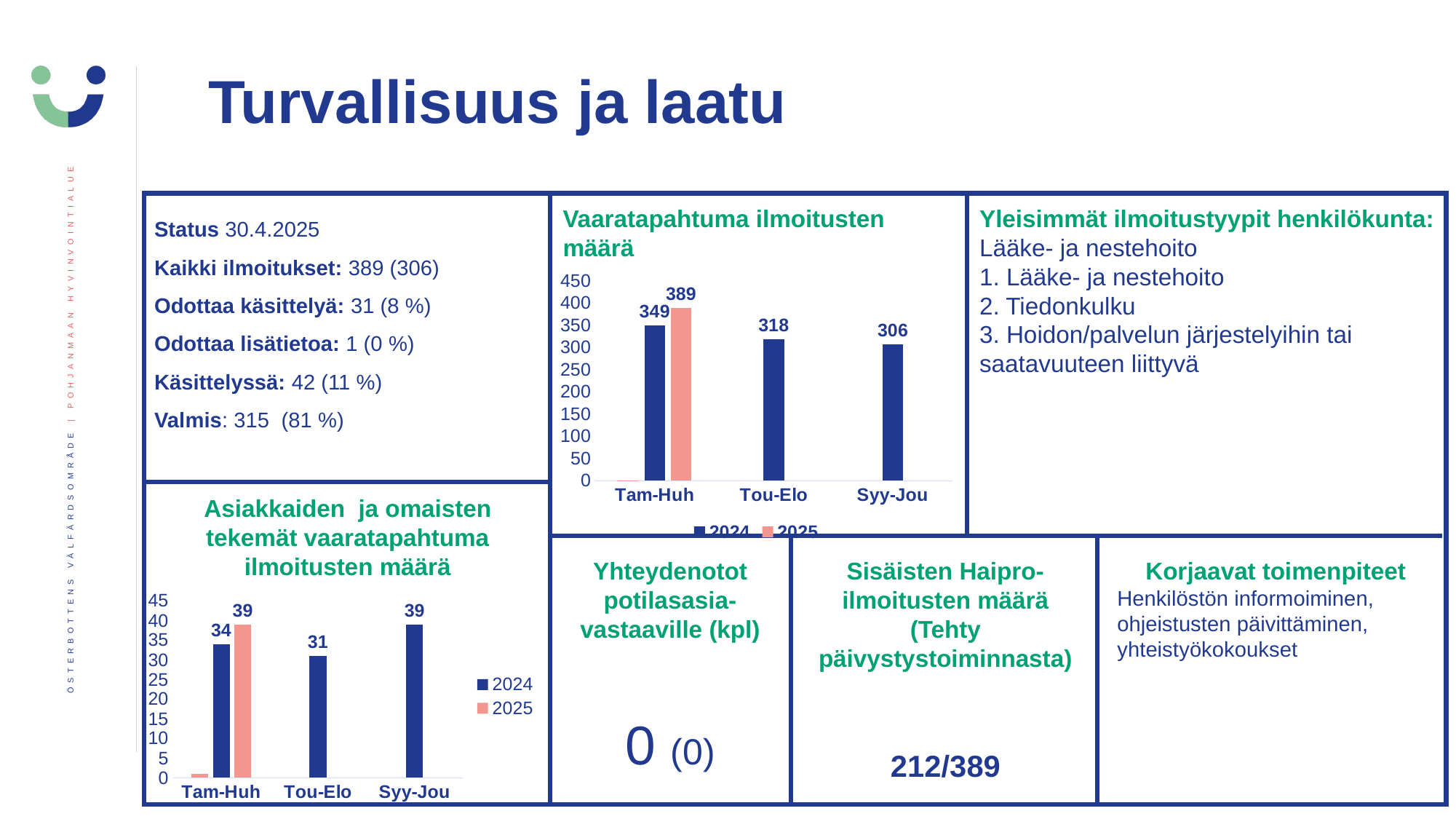
In the chart titled "Asiakkaiden ja omaisten tekemät vaaratapahtuma ilmoitusten määrä", which is larger for Tam-Huh: the 2024 value or the 2025 value? 2025 In the chart titled "Vaaratapahtuma ilmoitusten määrä", which period has the lowest 2024 value? Syy-Jou In the chart titled "Asiakkaiden ja omaisten tekemät vaaratapahtuma ilmoitusten määrä", which period has the highest 2024 value? Syy-Jou In the chart titled "Asiakkaiden ja omaisten tekemät vaaratapahtuma ilmoitusten määrä", what is the 2024 value for Tou-Elo? 31 In the chart titled "Vaaratapahtuma ilmoitusten määrä", what is the difference between the 2025 and 2024 values for Tam-Huh? 40 In the chart titled "Asiakkaiden ja omaisten tekemät vaaratapahtuma ilmoitusten määrä", how many series does the legend list? 2 In the chart titled "Vaaratapahtuma ilmoitusten määrä", how many periods are shown on the x axis? 3 In the chart titled "Vaaratapahtuma ilmoitusten määrä", what is the 2025 value for Tam-Huh? 389 In the chart titled "Vaaratapahtuma ilmoitusten määrä", what is the 2024 value for Syy-Jou? 306 In the chart titled "Asiakkaiden ja omaisten tekemät vaaratapahtuma ilmoitusten määrä", what is the 2025 value for Tam-Huh? 39 In the chart titled "Vaaratapahtuma ilmoitusten määrä", what is the 2024 value for Tam-Huh? 349 In the chart titled "Vaaratapahtuma ilmoitusten määrä", do the 2024 values rise or fall from Tam-Huh to Syy-Jou? fall